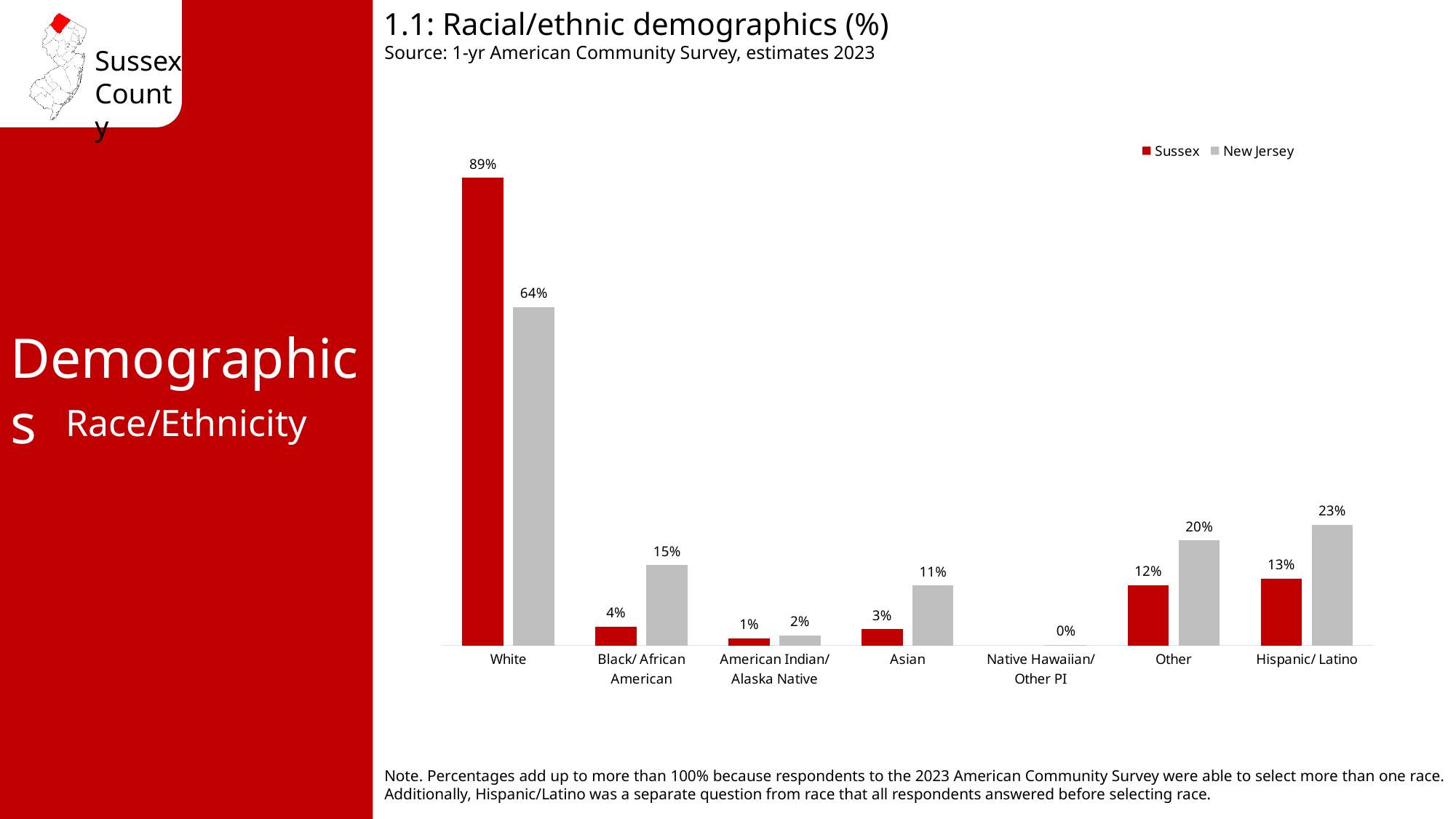
How many series does the legend list? 2 Which is larger for Asian, the Sussex value or the New Jersey value? New Jersey What is the Sussex value for Other? 12% What is the difference between the Sussex and New Jersey values for White? 25% Which category has the lowest New Jersey value? Native Hawaiian/ Other PI What is the New Jersey value for Asian? 11% How many categories are shown on the x axis? 7 What is the New Jersey value for Hispanic/ Latino? 23% Which category has the highest Sussex value? White What is the difference between the New Jersey and Sussex values for Black/ African American? 11% What kind of chart is shown on the slide? Bar chart What is the Sussex value for White? 89%